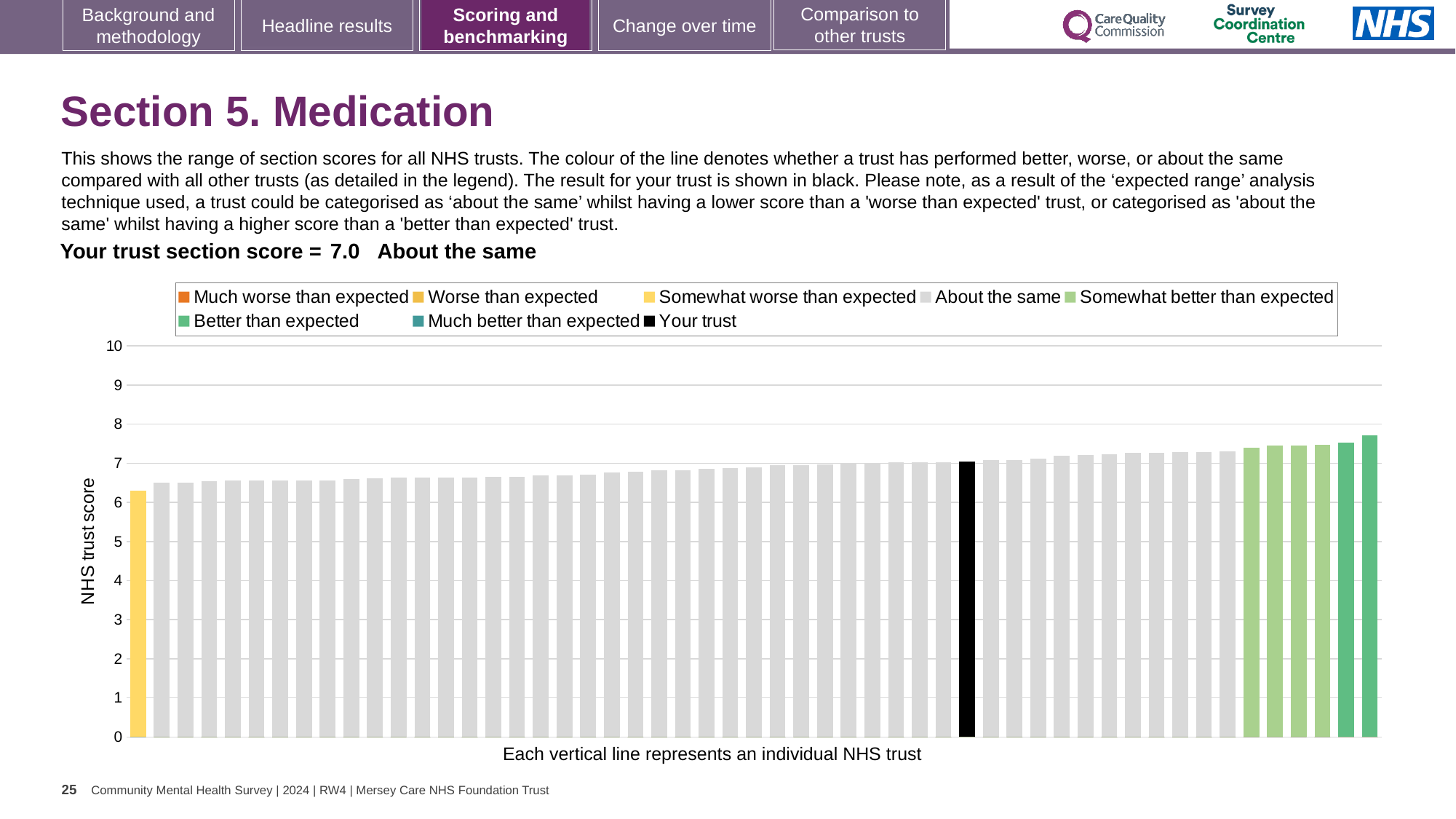
What is the label on the vertical axis of the chart? NHS trust score Is the value of the black bar (your trust) greater or less than 5? greater What colour is used for the bar representing your trust? black What is the section score for your trust shown on the slide? 7.0 Is the value of the leftmost (lowest) bar greater or less than 5? greater How many entries does the chart legend list? 8 Do the bar values rise or fall from left to right along the x axis? rise Is the value of the rightmost (highest) bar greater or less than 8? less Which is larger, the leftmost bar or the rightmost bar? the rightmost bar What kind of chart is shown on the slide? bar chart Which category is your trust placed in for this section? About the same